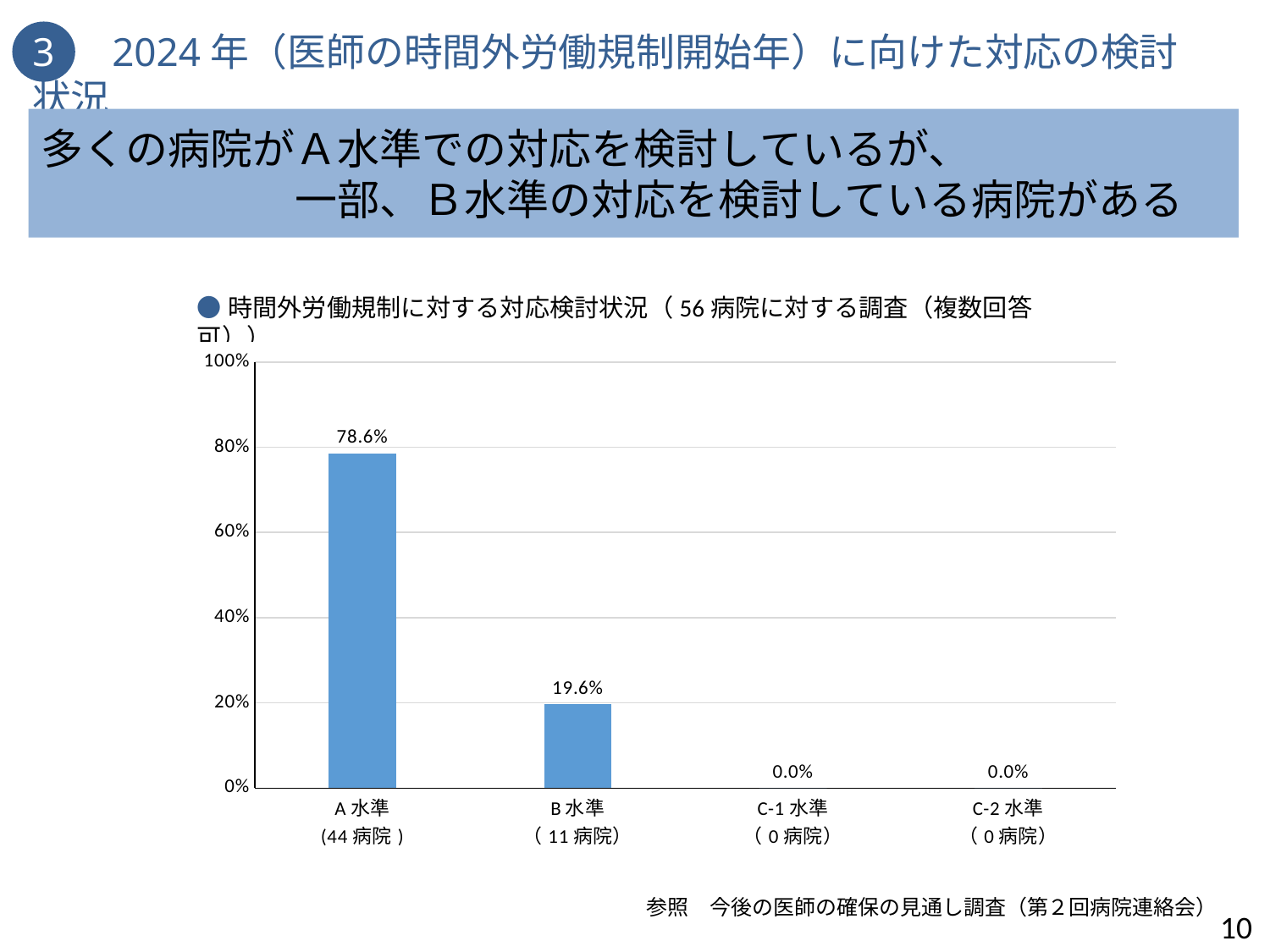
How many categories are shown on the x axis? 4 How many hospitals are indicated under the A水準 category label? 44病院 Which is larger, the value for A水準 or the value for B水準? A水準 Is the value for B水準 greater or less than 40%? less What is the difference between the values for A水準 and B水準? 59.0% What is the value for A水準? 78.6% What is the value for C-1水準? 0.0% Which category has the highest value? A水準 What kind of chart is shown on the slide? bar chart What is the value for B水準? 19.6% Is the value for A水準 greater or less than 60%? greater Do the values rise or fall from A水準 to C-2水準 along the x axis? fall